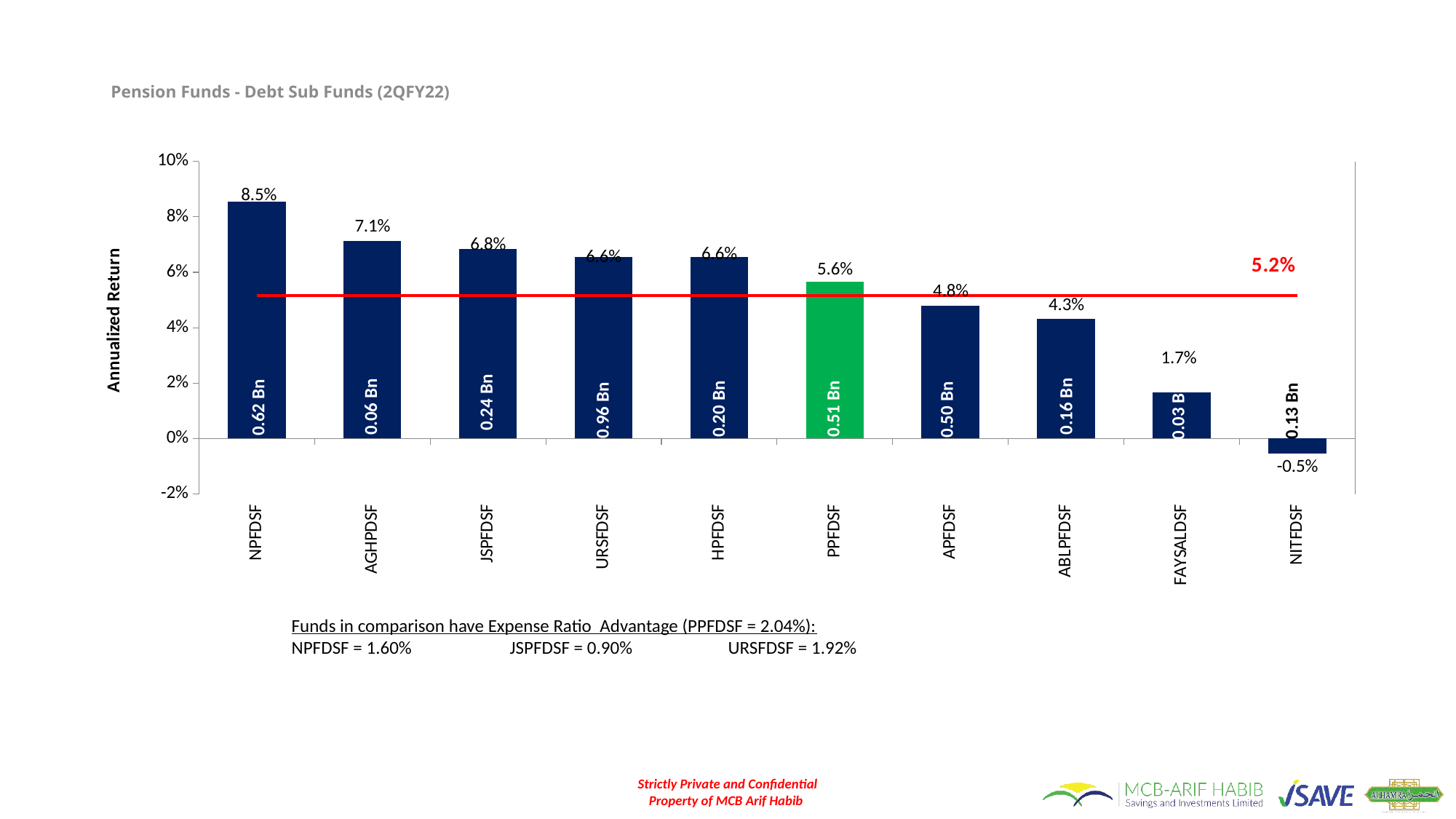
What is the title of the chart? Pension Funds - Debt Sub Funds (2QFY22) What is the annualized return for NITFDSF? -0.5% Which has a higher annualized return, APFDSF or ABLPFDSF? APFDSF How many funds are shown on the chart? 10 Which fund has the highest annualized return? NPFDSF What is the difference between the annualized returns of NPFDSF and AGHPDSF? 1.4% What fund size is labelled inside the bar for URSFDSF? 0.96 Bn What is the annualized return for PPFDSF? 5.6% What value does the red horizontal line mark? 5.2% What type of chart is shown on the slide? Bar chart What is the annualized return for NPFDSF? 8.5% Which fund has the lowest annualized return? NITFDSF